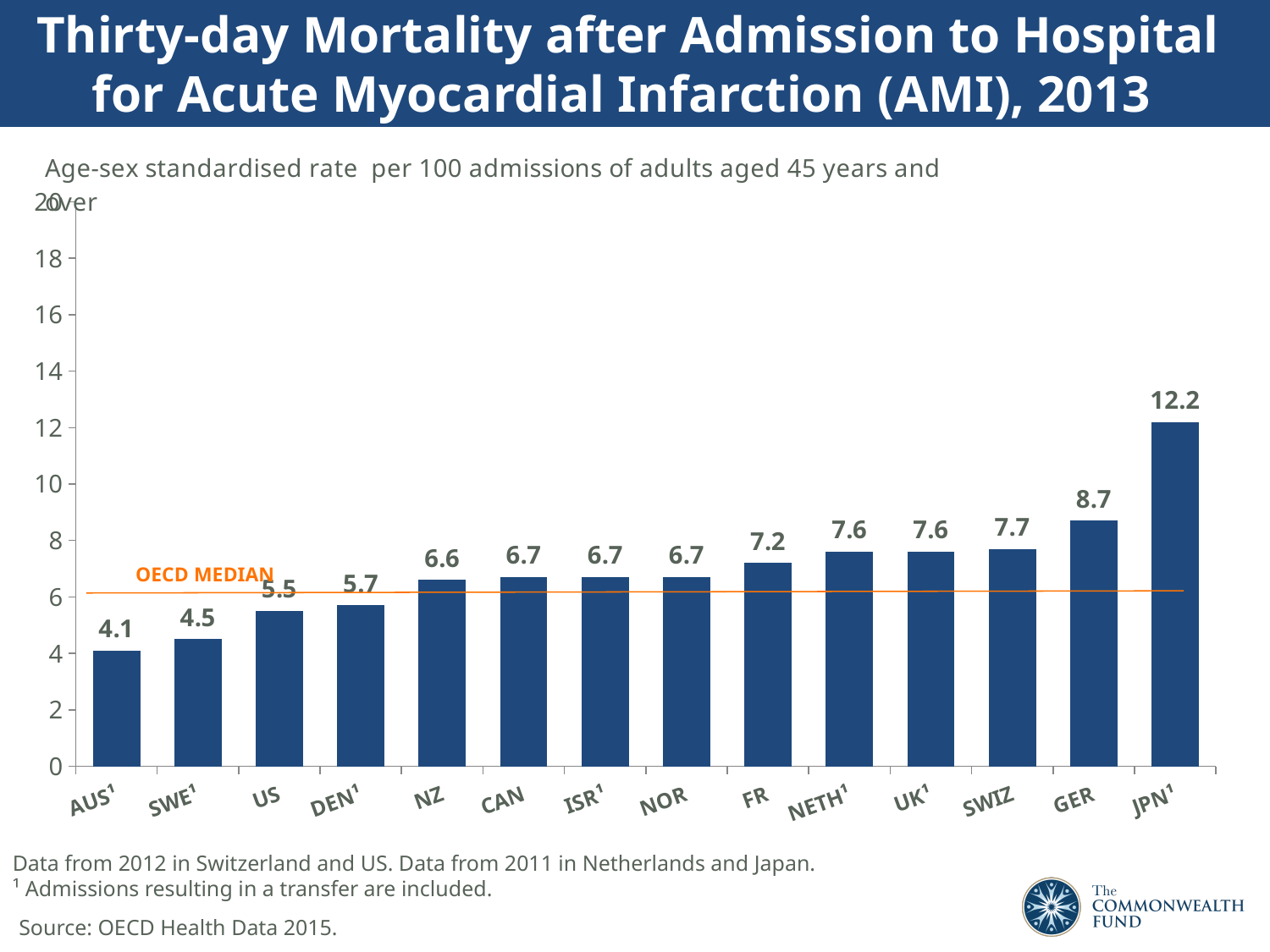
What does the orange horizontal line on the chart represent? OECD MEDIAN What is the difference between the rates for Japan (JPN) and Australia (AUS)? 8.1 What kind of chart is shown on the slide? Bar chart What is the thirty-day AMI mortality rate for the US? 5.5 Which country has the highest thirty-day AMI mortality rate? JPN Which country has the lowest thirty-day AMI mortality rate? AUS What is the thirty-day AMI mortality rate for Germany (GER)? 8.7 What is the thirty-day AMI mortality rate for Japan (JPN)? 12.2 What is the difference between the rates for Germany (GER) and Switzerland (SWIZ)? 1.0 Which has a higher thirty-day AMI mortality rate, France (FR) or Denmark (DEN)? FR Is the value for Japan (JPN) greater or less than 10? greater How many countries are shown on the chart? 14